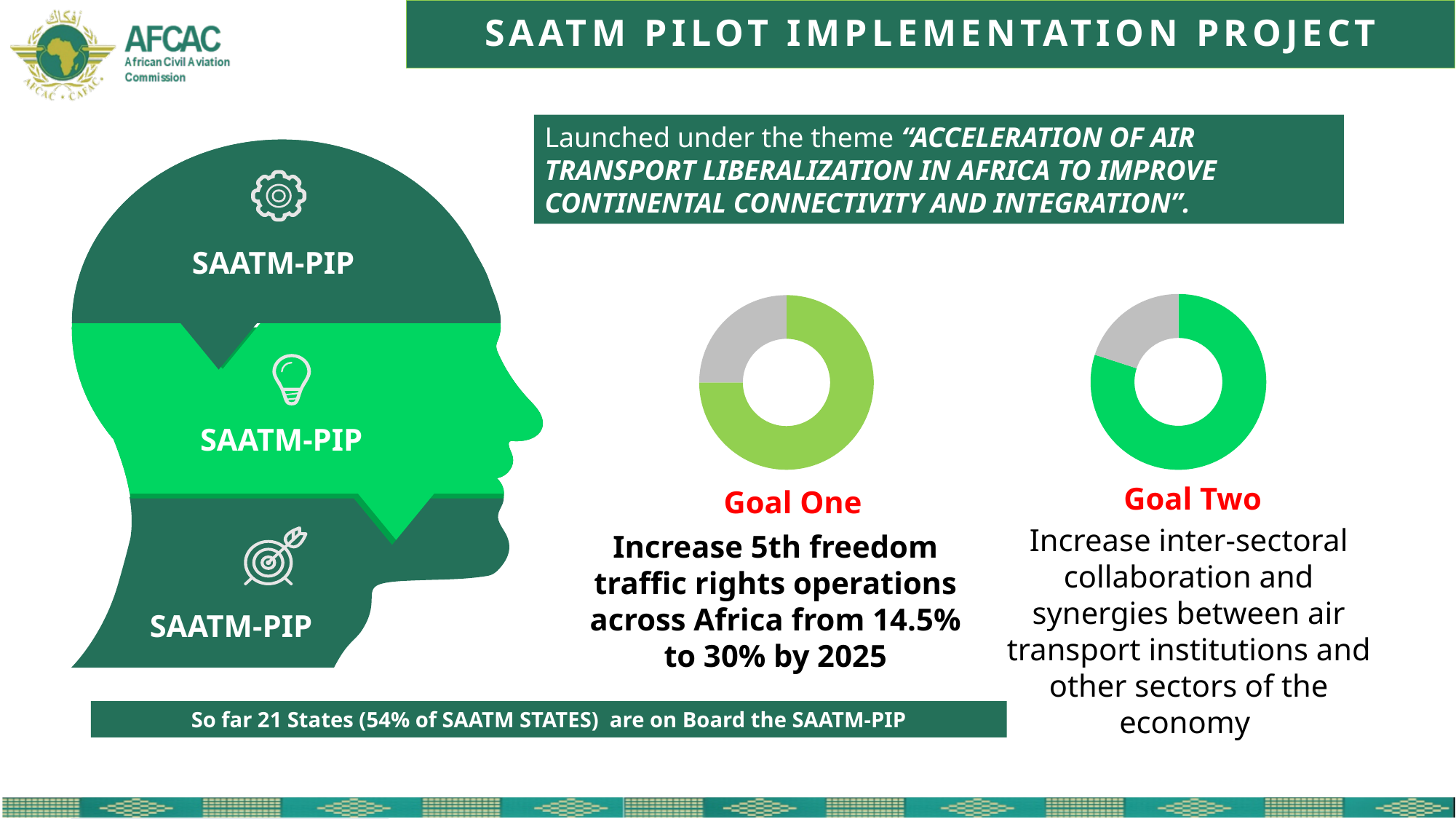
Does either doughnut chart display a legend? No In the Goal One doughnut chart, which slice is larger, the green one or the grey one? The green one In the Goal Two doughnut chart, how many slices are there? 2 How many charts are on the slide? 2 In the Goal One doughnut chart, how many slices are there? 2 Comparing the grey slices of the two doughnut charts, which chart has the larger grey slice, Goal One or Goal Two? Goal One What colour is the smaller slice in the Goal One doughnut chart? Grey What kind of chart is shown above the "Goal Two" label? Doughnut chart What kind of chart is shown above the "Goal One" label? Doughnut chart In the Goal Two doughnut chart, which slice is larger, the green one or the grey one? The green one